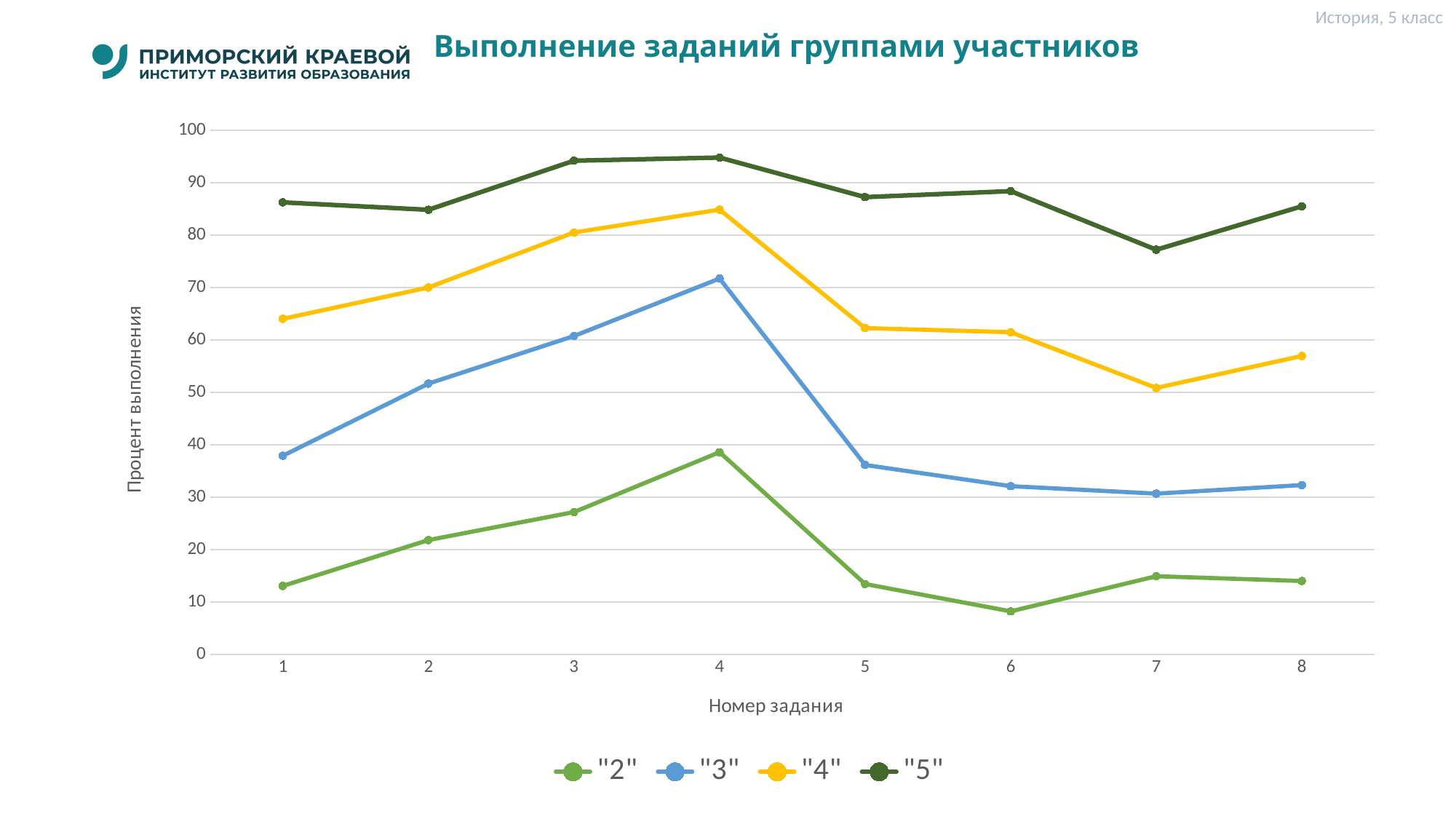
For which task number does the "4" series reach its lowest value? 7 How many series does the legend list? 4 What kind of chart is shown on the slide? line chart For which task number does the "2" series reach its highest value? 4 Is the value for the "4" series at task 7 greater or less than 60? less Is the value for the "5" series at task 3 greater or less than 90? greater How many tasks (points) are plotted along the x axis? 8 For which task number does the "3" series reach its highest value? 4 Does the "3" series rise or fall from task 1 to task 4? rise For which task number does the "2" series reach its lowest value? 6 For which task number does the "5" series reach its lowest value? 7 At task 1, which series has the larger value: "3" or "4"? "4"